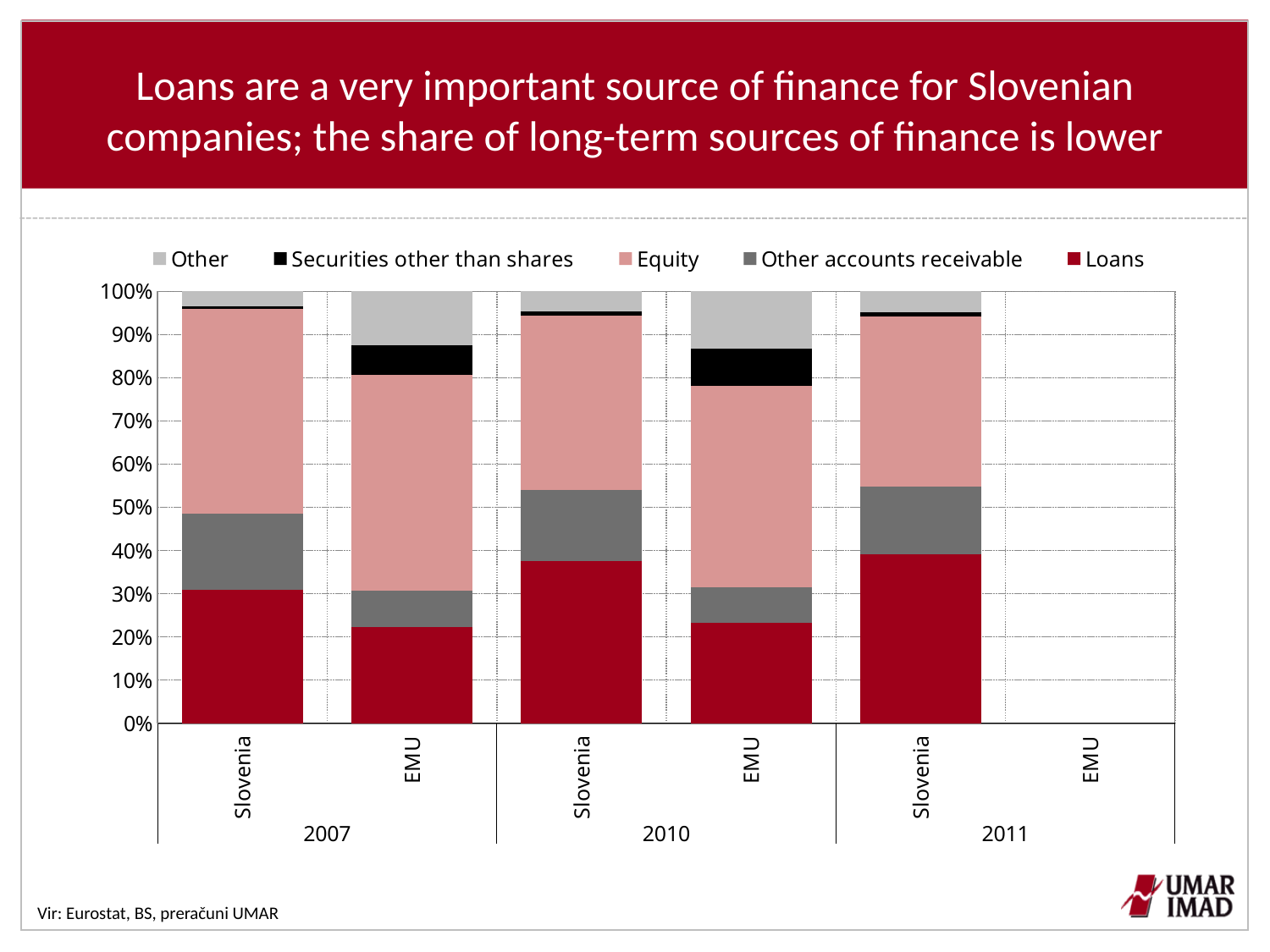
Is the Loans share for EMU in 2010 greater or less than 30%? less How many stacked bars are actually plotted on the chart? 5 Is the Loans share for EMU in 2007 greater or less than 30%? less What kind of chart is shown on the slide? Stacked bar chart How many series does the legend list? 5 Does the Loans share for Slovenia rise or fall from 2007 to 2011? rise How many year groups are shown on the x axis? 3 Is the Loans share for Slovenia in 2010 greater or less than 30%? greater In 2010, which has the larger Loans share, Slovenia or EMU? Slovenia In 2007, which has the larger share of Securities other than shares, Slovenia or EMU? EMU Which series is shown in dark red? Loans